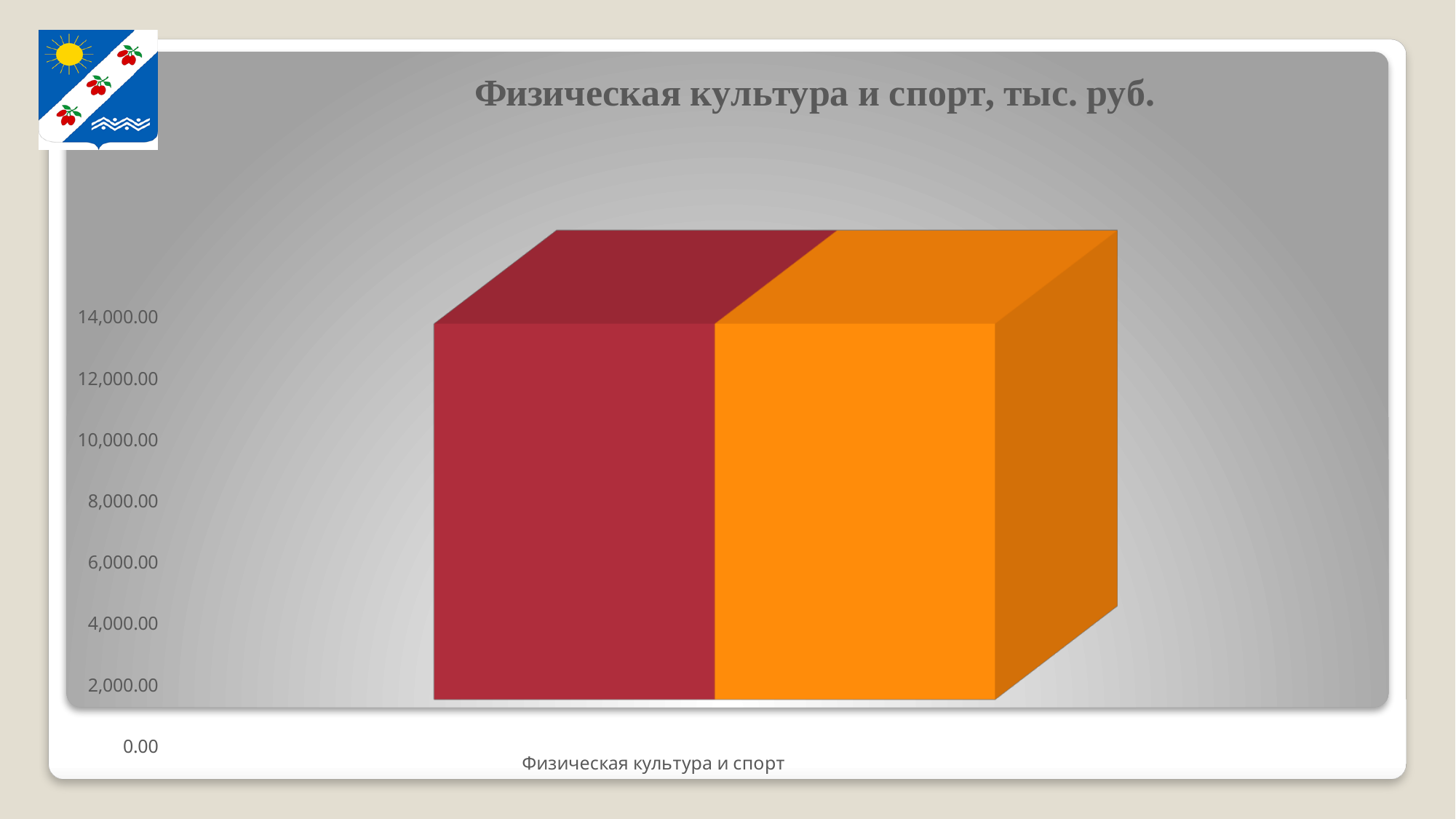
What is the category label shown on the x axis? Физическая культура и спорт How many categories are shown on the x axis of the chart? 1 Is the value of the red bar greater or less than 12,000.00? greater Is the value of the orange bar greater or less than 8,000.00? greater What kind of chart is shown on the slide? bar chart How many bars are plotted in the chart? 2 Is the value of the orange bar greater or less than 12,000.00? greater What is the highest tick value shown on the vertical axis? 14,000.00 What is the title of the chart? Физическая культура и спорт, тыс. руб.